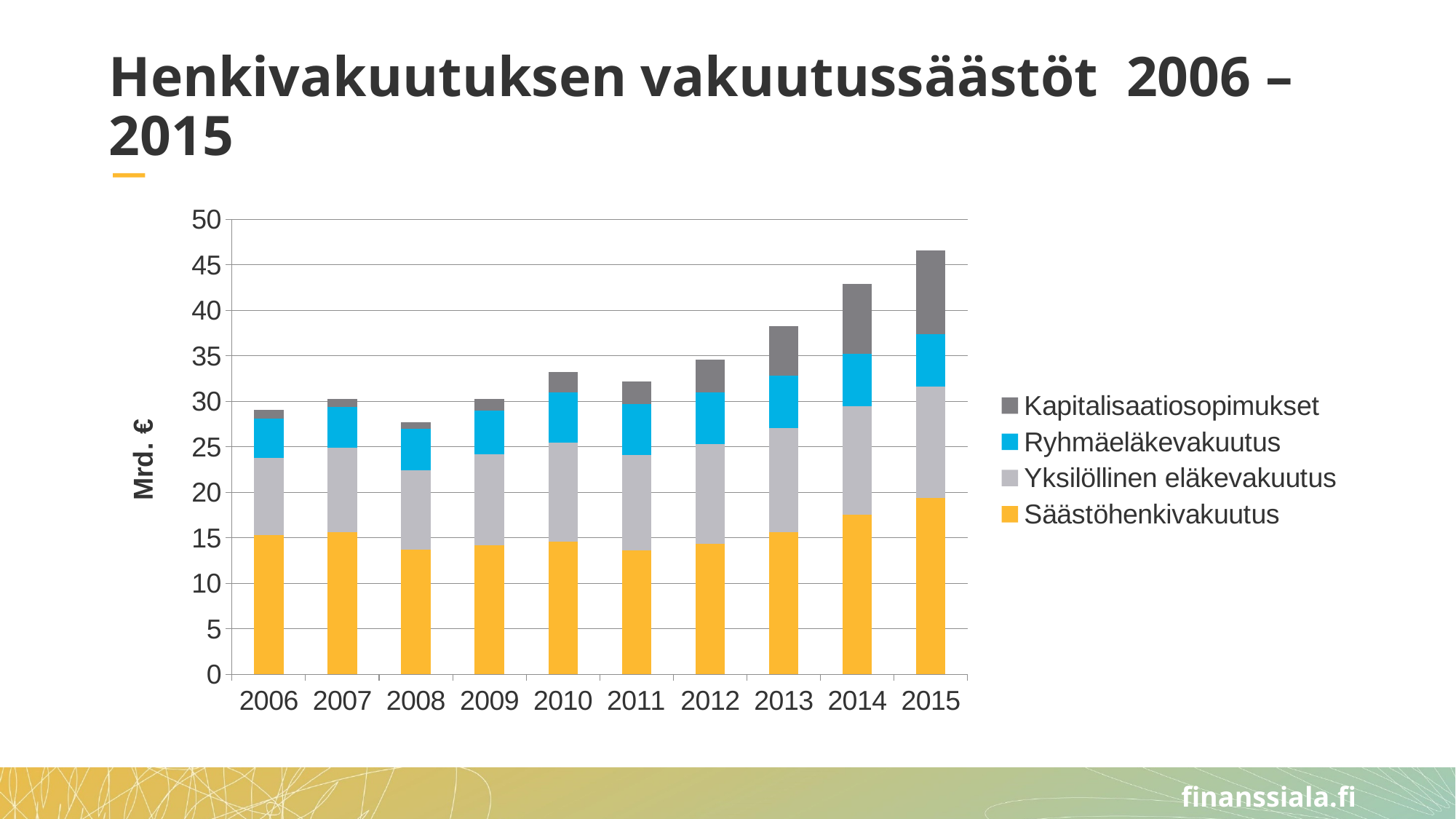
Which year has the lowest total stacked bar? 2008 Do the total values generally rise or fall from 2006 to 2015? rise Which year has the highest total stacked bar? 2015 What unit is shown on the y axis label of the chart? Mrd. € Is the total value for 2014 greater or less than 40? greater Is the Säästöhenkivakuutus value for 2015 greater or less than 15? greater How many series does the chart's legend list? 4 How many years are shown on the x axis of the chart? 10 Is the total value for 2015 greater or less than 45? greater Which year has the larger total stacked bar, 2013 or 2014? 2014 What kind of chart is shown on the slide? Stacked bar chart